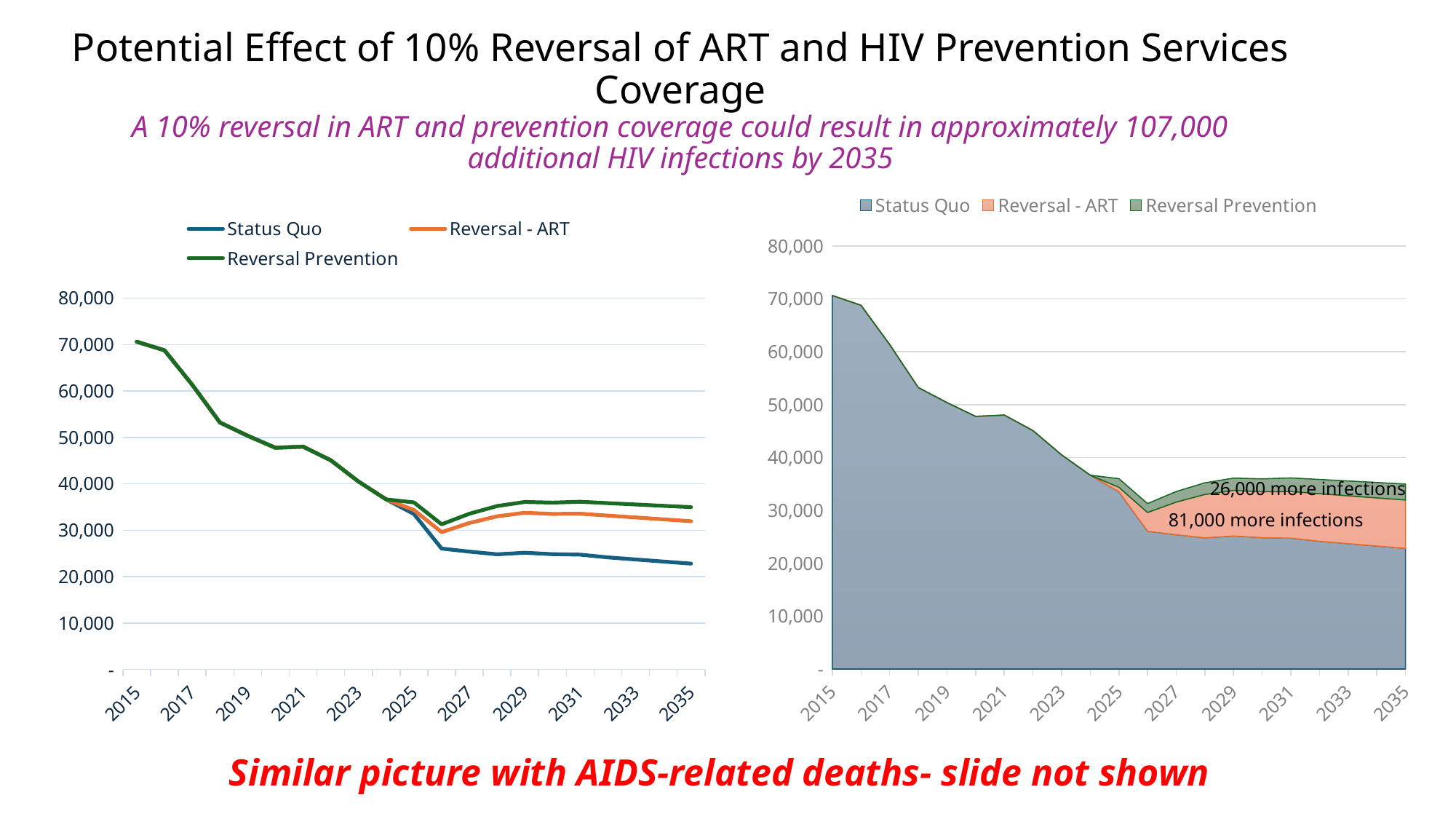
In the left chart, is the Reversal Prevention value for 2015 greater or less than 60,000? greater How many series does the legend of the left chart list? 3 In the left chart, is the Status Quo value for 2035 greater or less than 30,000? less What kind of chart is the chart on the left of the slide? line chart In the left chart, which series has the highest value in 2035? Reversal Prevention In the left chart, does the Status Quo series rise or fall from 2015 to 2035? fall In the left chart, is the Reversal - ART value for 2027 greater or less than 40,000? less In the left chart, which series has the lowest value in 2035? Status Quo In the left chart, which is larger in 2035: Reversal Prevention or Status Quo? Reversal Prevention What kind of chart is the chart on the right of the slide? area chart How many year labels are shown on the x axis of the right chart? 11 In the right chart, what label is printed on the Reversal - ART area? 81,000 more infections